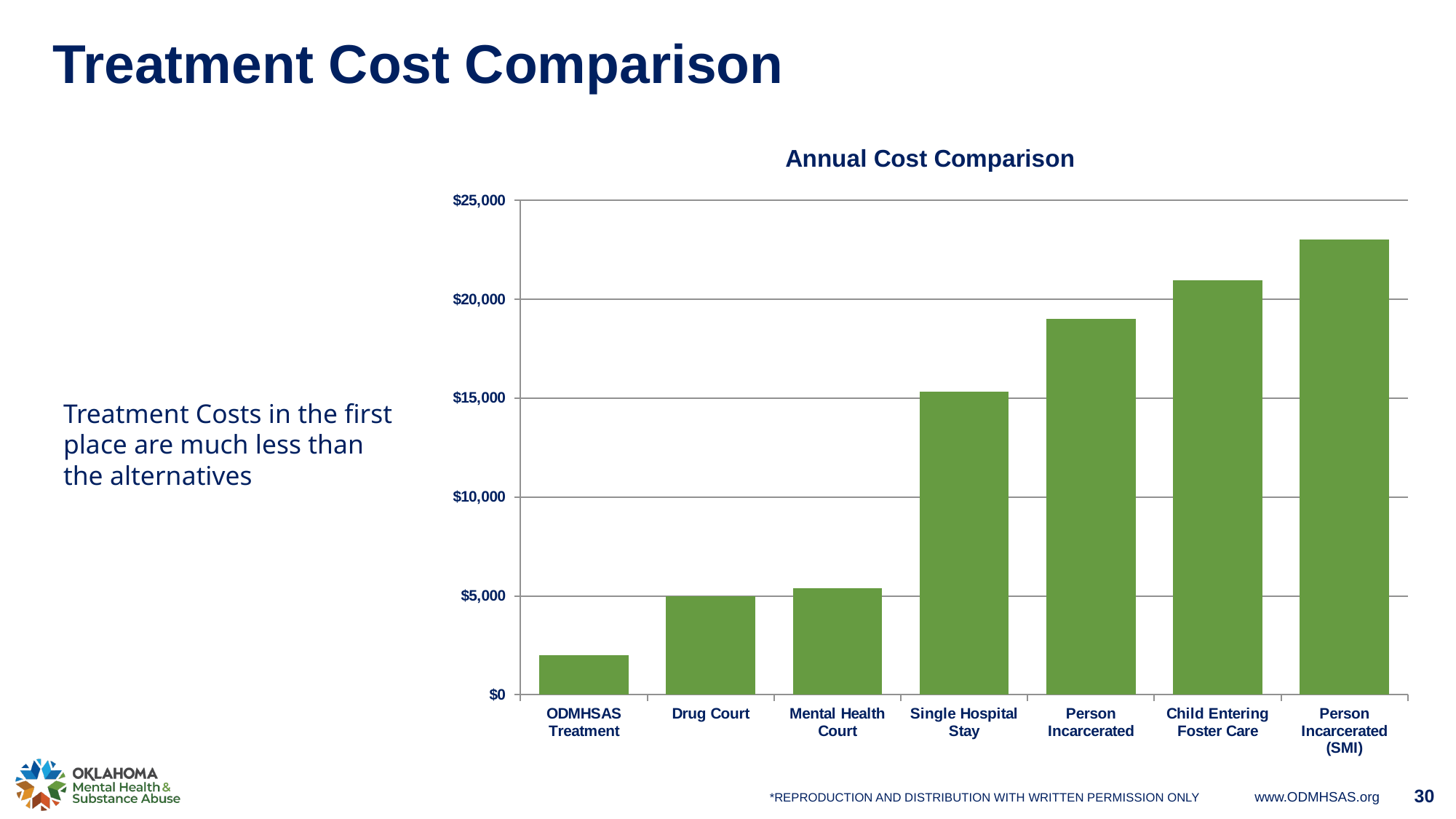
Is the value for ODMHSAS Treatment greater or less than $5,000? less Which category has the highest annual cost? Person Incarcerated (SMI) Which category has the lowest annual cost? ODMHSAS Treatment Which has a higher annual cost, Single Hospital Stay or Drug Court? Single Hospital Stay Is the value for Child Entering Foster Care greater or less than $20,000? greater What is the title of the chart? Annual Cost Comparison Do the values rise or fall moving from left to right along the x axis? Rise Is the value for Person Incarcerated (SMI) greater or less than $25,000? less How many categories are shown on the x axis of the chart? 7 What type of chart is shown on the slide? Bar chart